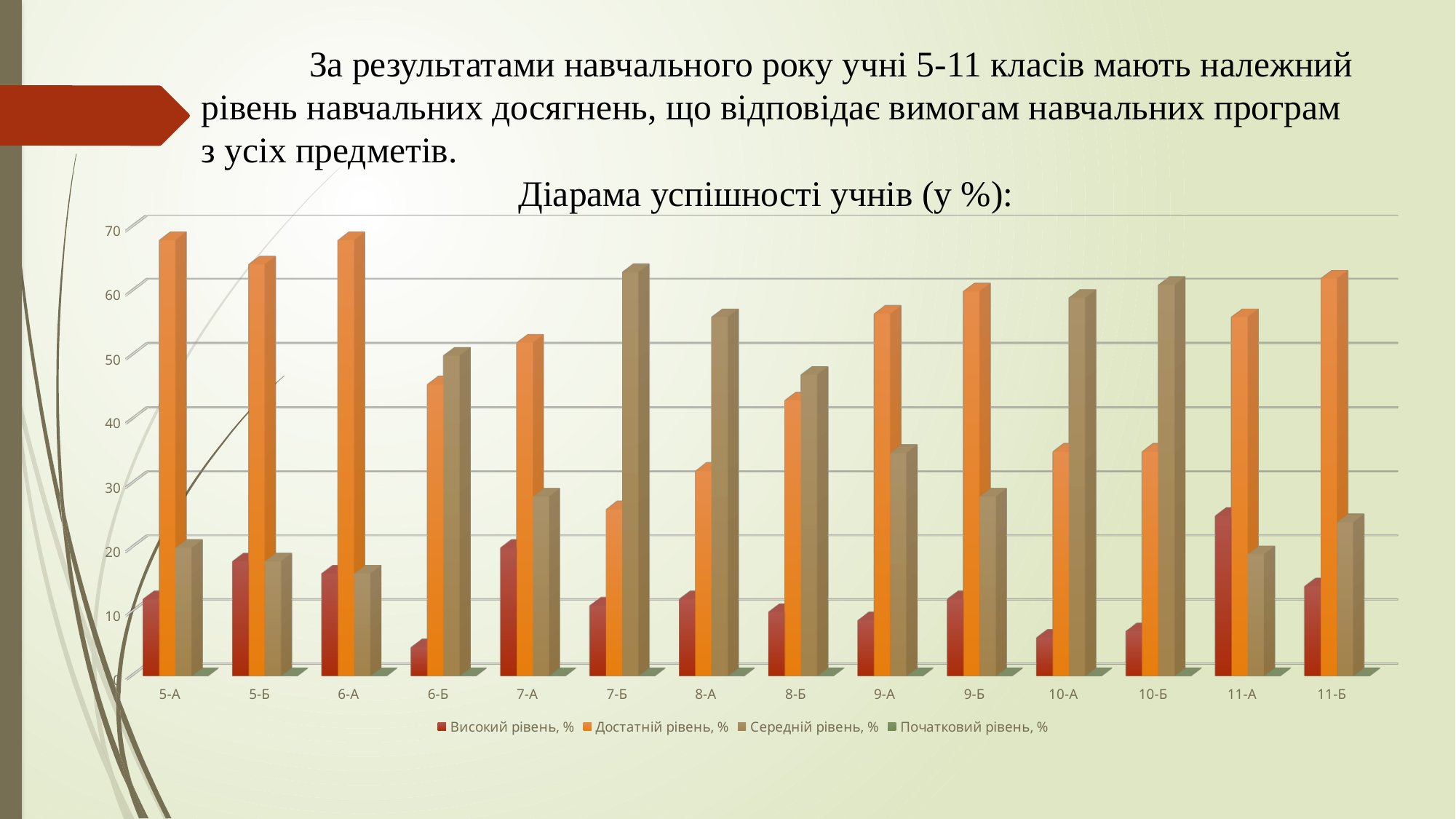
Is the value for Середній рівень, % for 7-Б greater or less than 60? greater Is the value for Високий рівень, % for 6-Б greater or less than 10? less For class 5-А, which is larger: Достатній рівень, % or Середній рівень, %? Достатній рівень, % What kind of chart is shown on the slide? bar chart Which class has the lowest value for Високий рівень, %? 6-Б Which class has the highest value for Високий рівень, %? 11-А For class 7-Б, which is larger: Достатній рівень, % or Середній рівень, %? Середній рівень, % How many series does the chart legend list? 4 Is the value for Достатній рівень, % for 5-А greater or less than 60? greater How many classes (categories) are shown on the x axis of the chart? 14 What is the title of the chart? Діарама успішності учнів (у %): Which class has the lowest value for Достатній рівень, %? 7-Б